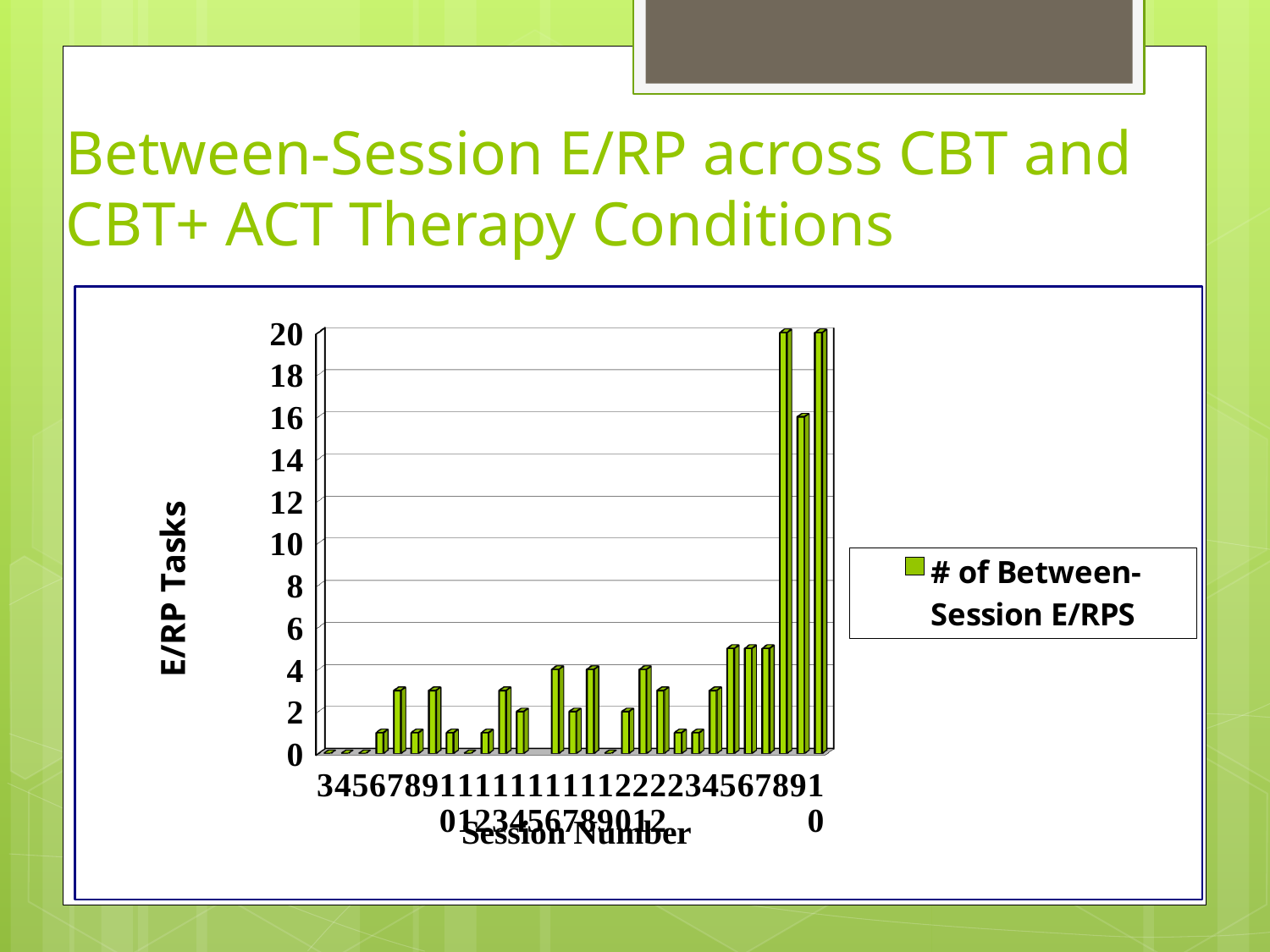
Is the value of the leftmost bar greater or less than 2? less Do the bar values generally rise or fall from left to right along the x axis? rise Is the value of the rightmost bar greater or less than 10? greater What is the legend entry for the series in the chart? # of Between-Session E/RPS Is the value of the tallest bar greater or less than 18? greater What is the highest tick value shown on the vertical axis? 20 What kind of chart is shown on the slide? bar chart What is the title of the vertical axis? E/RP Tasks How many series does the legend list? 1 Which is larger, the value of the leftmost bar or the value of the rightmost bar? the rightmost bar